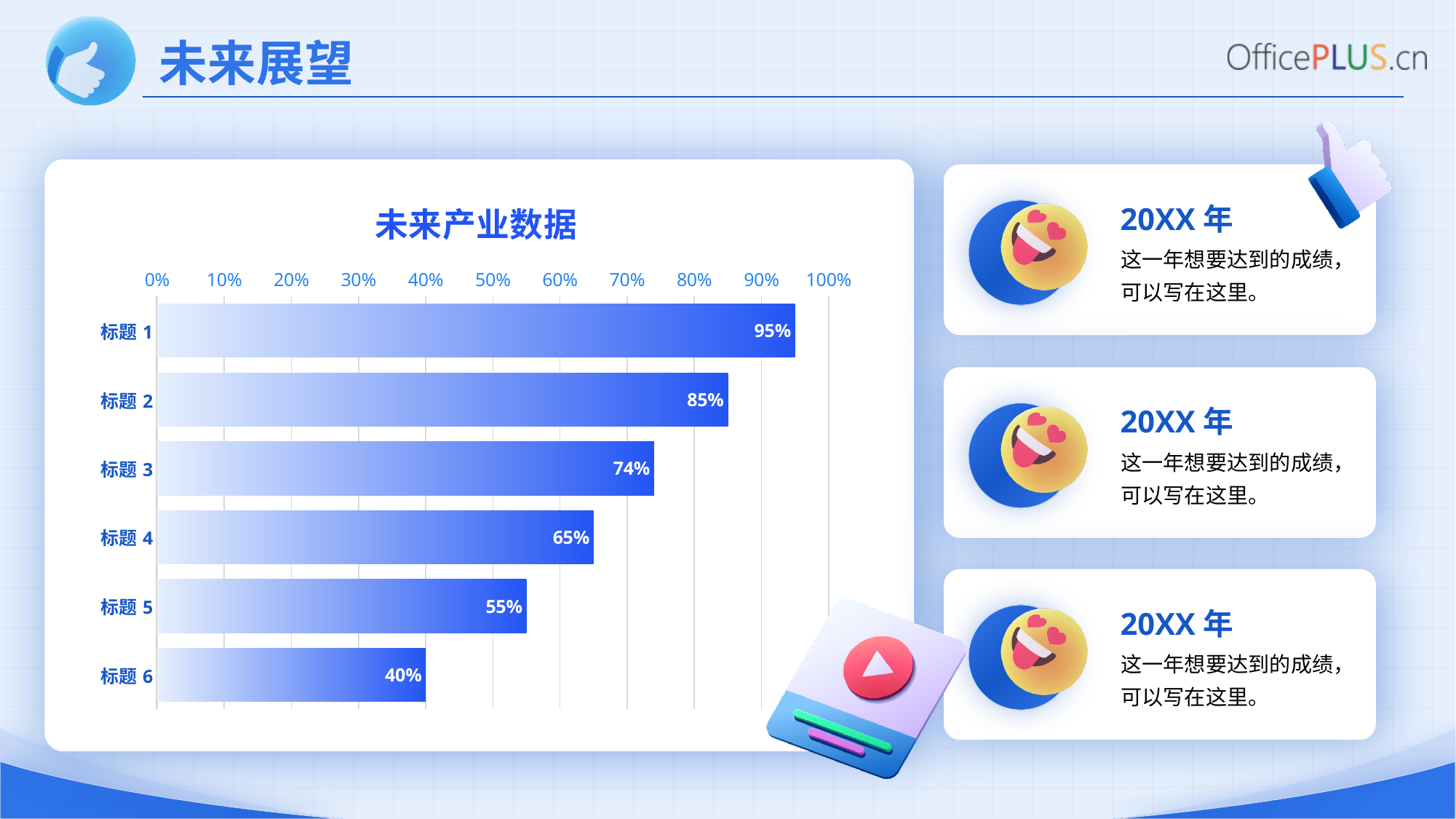
What is the difference between the values for 标题 2 and 标题 3? 11% What is the value for 标题 6? 40% Is the value for 标题 3 greater or less than 70%? greater What is the difference between the values for 标题 1 and 标题 6? 55% What kind of chart is shown on the slide? bar chart How many categories are shown in the chart? 6 Which category has the lowest value? 标题 6 What is the value for 标题 1? 95% Which category has the highest value? 标题 1 What is the title of the chart? 未来产业数据 What is the value for 标题 4? 65% Which is larger, the value for 标题 4 or the value for 标题 5? 标题 4